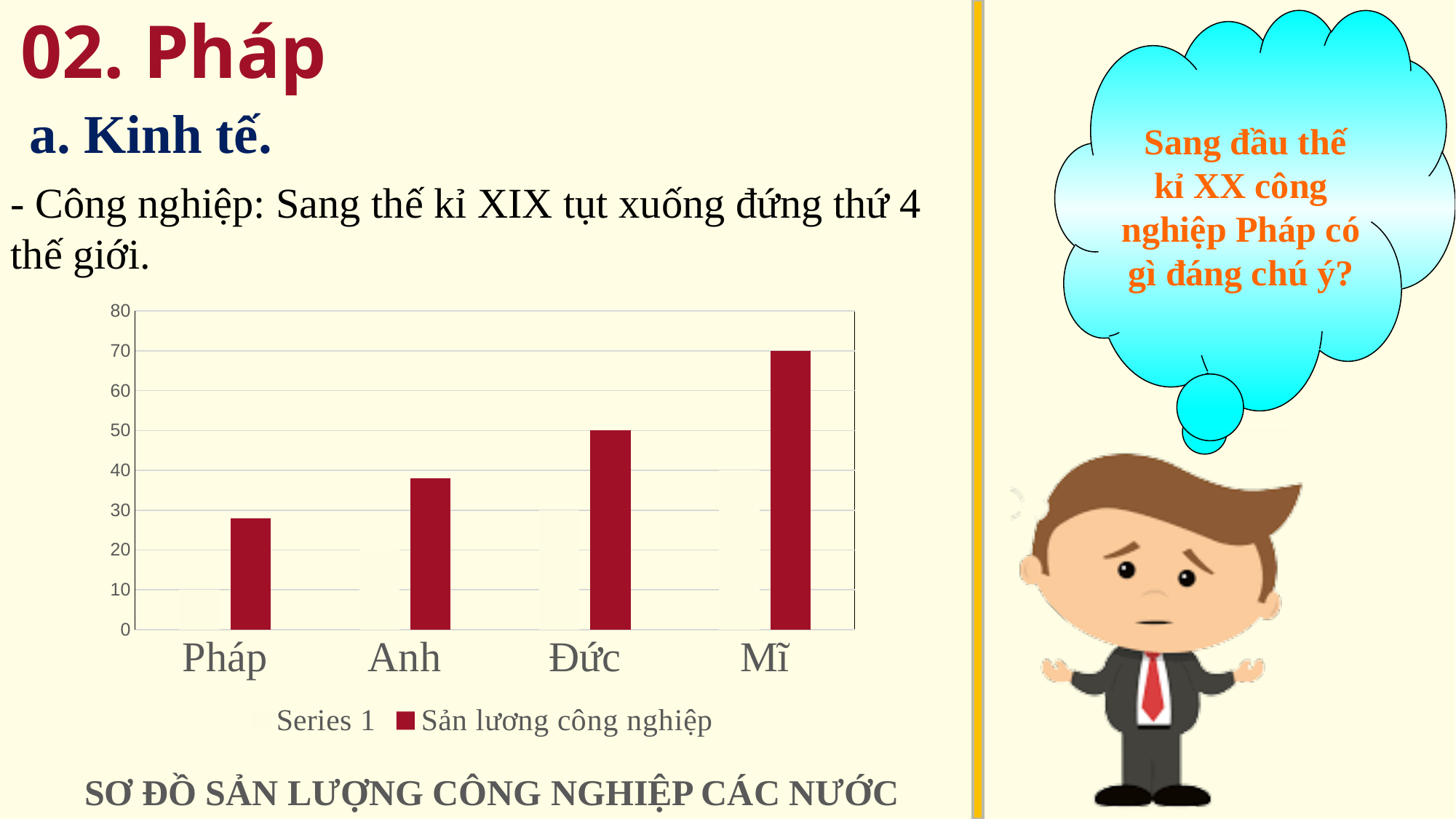
What is the value for Đức in the chart? 50 Is the value for Anh greater or less than 30? greater What kind of chart is shown on the slide? bar chart Which is larger, the value for Anh or the value for Đức? Đức What is the value for Mĩ in the chart? 70 What is the difference between the values for Mĩ and Đức? 20 What is the caption written below the chart? SƠ ĐỒ SẢN LƯỢNG CÔNG NGHIỆP CÁC NƯỚC How many countries are shown on the x axis of the chart? 4 Do the bar values rise or fall from left to right across the x axis? rise Which country has the lowest bar in the chart? Pháp Is the value for Pháp greater or less than 30? less Which country has the highest bar in the chart? Mĩ